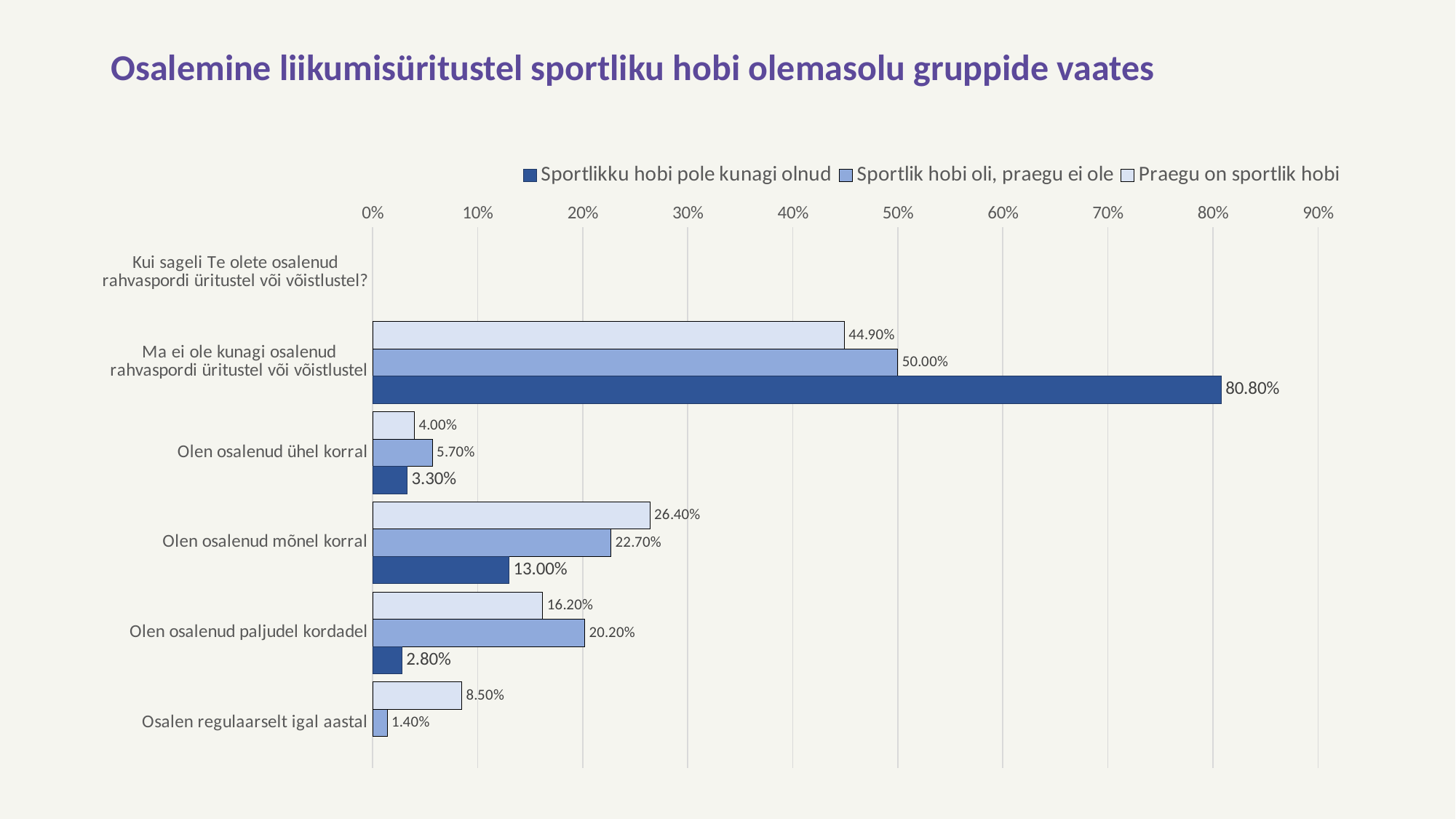
Which series has the lowest value in the category "Olen osalenud paljudel kordadel"? Sportlikku hobi pole kunagi olnud What is the value for "Sportlikku hobi pole kunagi olnud" in the category "Ma ei ole kunagi osalenud rahvaspordi üritustel või võistlustel"? 80.80% Which series has the highest value in the category "Ma ei ole kunagi osalenud rahvaspordi üritustel või võistlustel"? Sportlikku hobi pole kunagi olnud What is the title of the chart? Osalemine liikumisüritustel sportliku hobi olemasolu gruppide vaates How many series does the legend list? 3 What is the value for "Praegu on sportlik hobi" in the category "Osalen regulaarselt igal aastal"? 8.50% What is the value for "Sportlik hobi oli, praegu ei ole" in the category "Olen osalenud paljudel kordadel"? 20.20% What is the value for "Praegu on sportlik hobi" in the category "Olen osalenud mõnel korral"? 26.40% In the category "Olen osalenud mõnel korral", which is larger: "Praegu on sportlik hobi" or "Sportlik hobi oli, praegu ei ole"? Praegu on sportlik hobi What type of chart is shown on the slide? bar chart Is the value for "Sportlikku hobi pole kunagi olnud" in the category "Ma ei ole kunagi osalenud rahvaspordi üritustel või võistlustel" greater or less than 80%? greater What is the difference between "Sportlik hobi oli, praegu ei ole" and "Praegu on sportlik hobi" in the category "Ma ei ole kunagi osalenud rahvaspordi üritustel või võistlustel"? 5.10%